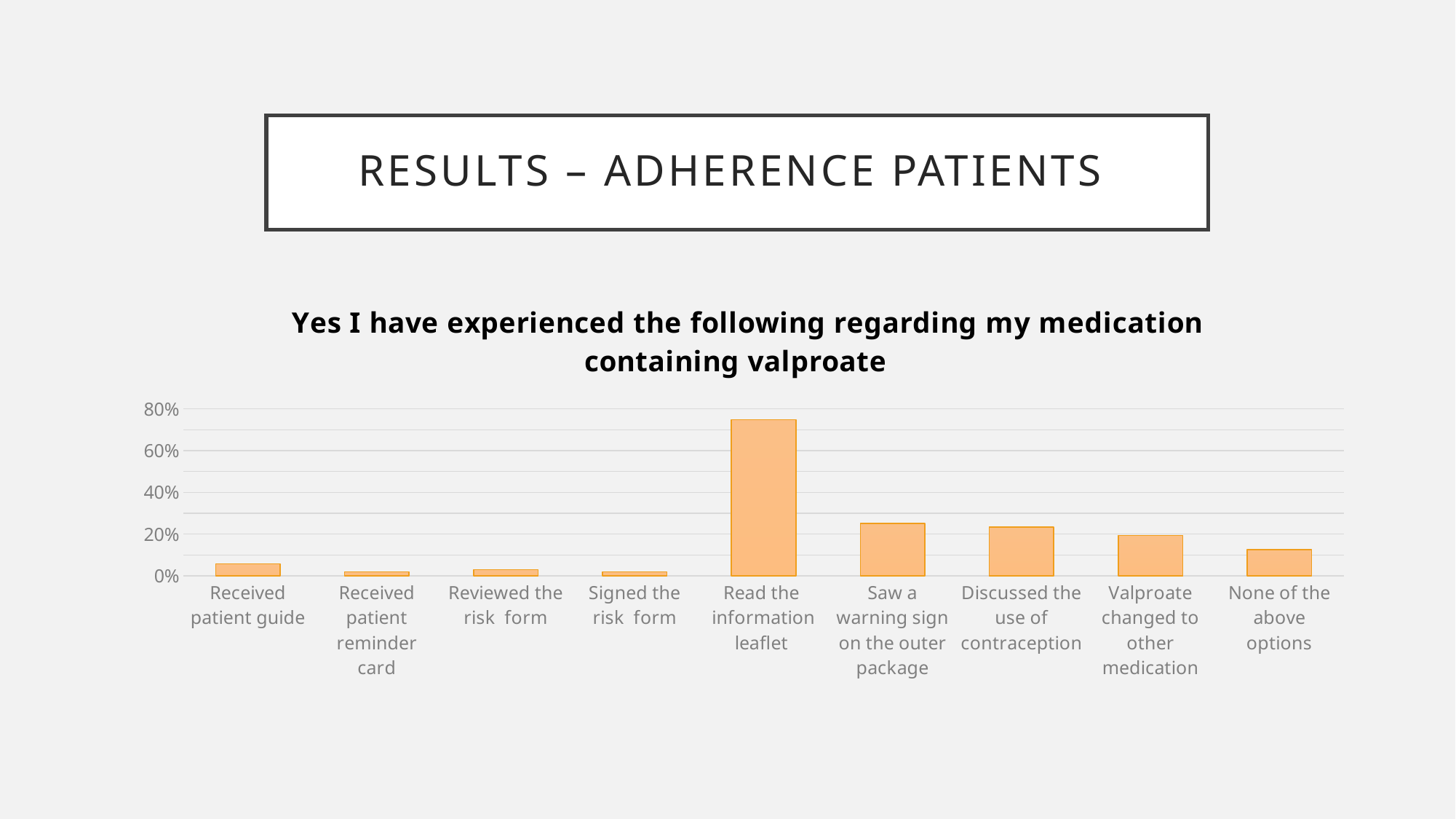
How many categories are plotted on the x axis of the chart? 9 What kind of chart is shown on the slide? bar chart Which category has the highest value in the chart? Read the information leaflet Is the value for 'Saw a warning sign on the outer package' greater or less than 20%? greater Is the value for 'Received patient guide' greater or less than 20%? less What is the title of the chart? Yes I have experienced the following regarding my medication containing valproate Which is larger: the value for 'Saw a warning sign on the outer package' or the value for 'None of the above options'? Saw a warning sign on the outer package Which is larger: the value for 'Read the information leaflet' or the value for 'Saw a warning sign on the outer package'? Read the information leaflet Which is larger: the value for 'Discussed the use of contraception' or the value for 'Received patient guide'? Discussed the use of contraception Is the value for 'Read the information leaflet' greater or less than 60%? greater